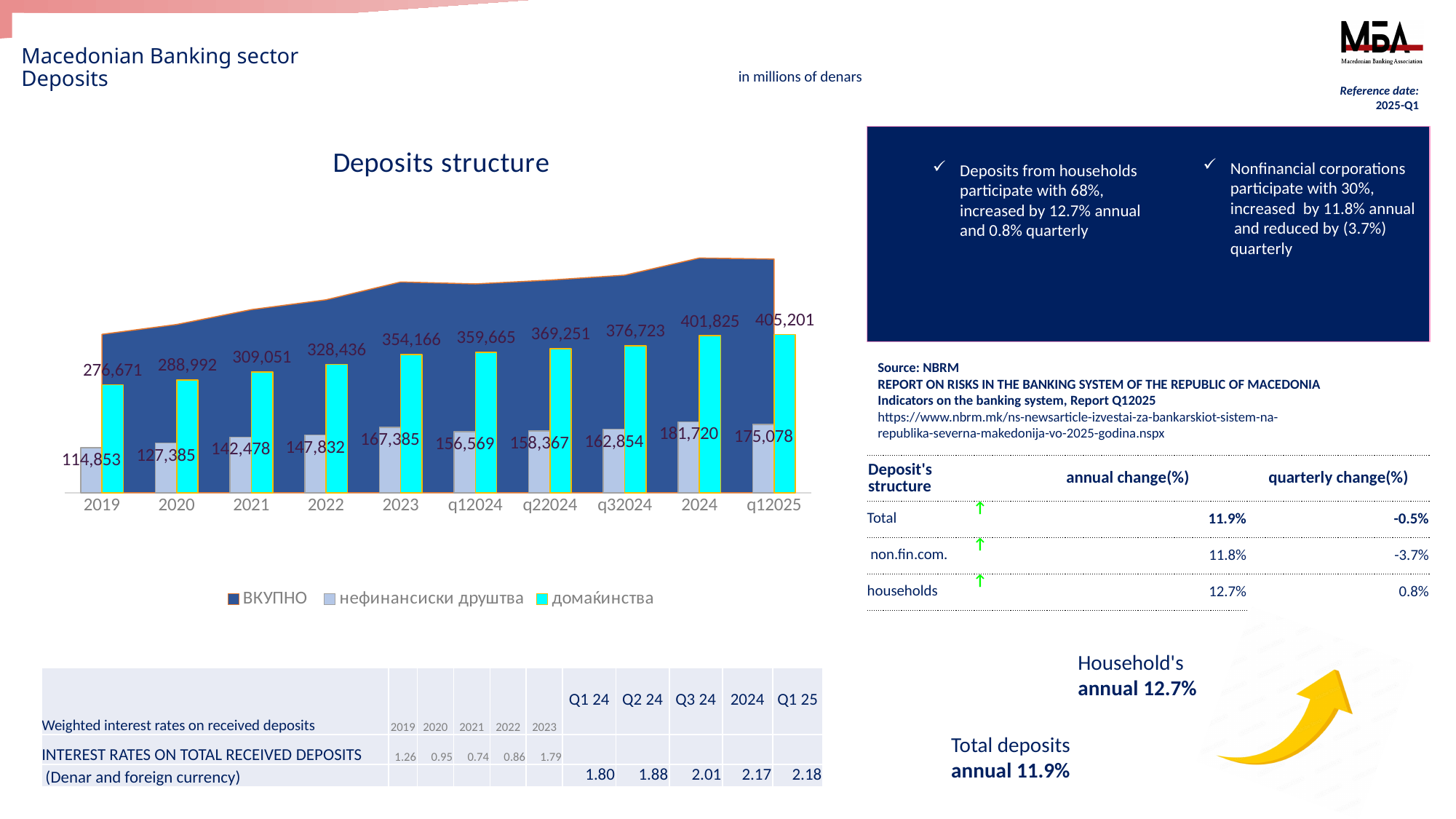
In the Deposits structure chart, do the домаќинства values rise or fall from 2019 to q12025? rise In the Deposits structure chart, what is the value of нефинансиски друштва for 2024? 181,720 In the Deposits structure chart, which period has the lowest value for нефинансиски друштва? 2019 How many periods are shown on the x axis of the Deposits structure chart? 10 In the Deposits structure chart, what is the value of домаќинства (households) for 2019? 276,671 In the Deposits structure chart, what is the value of домаќинства for q12025? 405,201 In the Deposits structure chart, what is the difference between the нефинансиски друштва values for 2024 and q12025? 6,642 In the Deposits structure chart, what is the difference between the домаќинства values for q12025 and 2024? 3,376 How many series does the legend of the Deposits structure chart list? 3 In the Deposits structure chart, what is the value of нефинансиски друштва for 2019? 114,853 In the Deposits structure chart, which period has the highest value for домаќинства? q12025 In the Deposits structure chart, which is larger for 2023: the value for домаќинства or the value for нефинансиски друштва? домаќинства